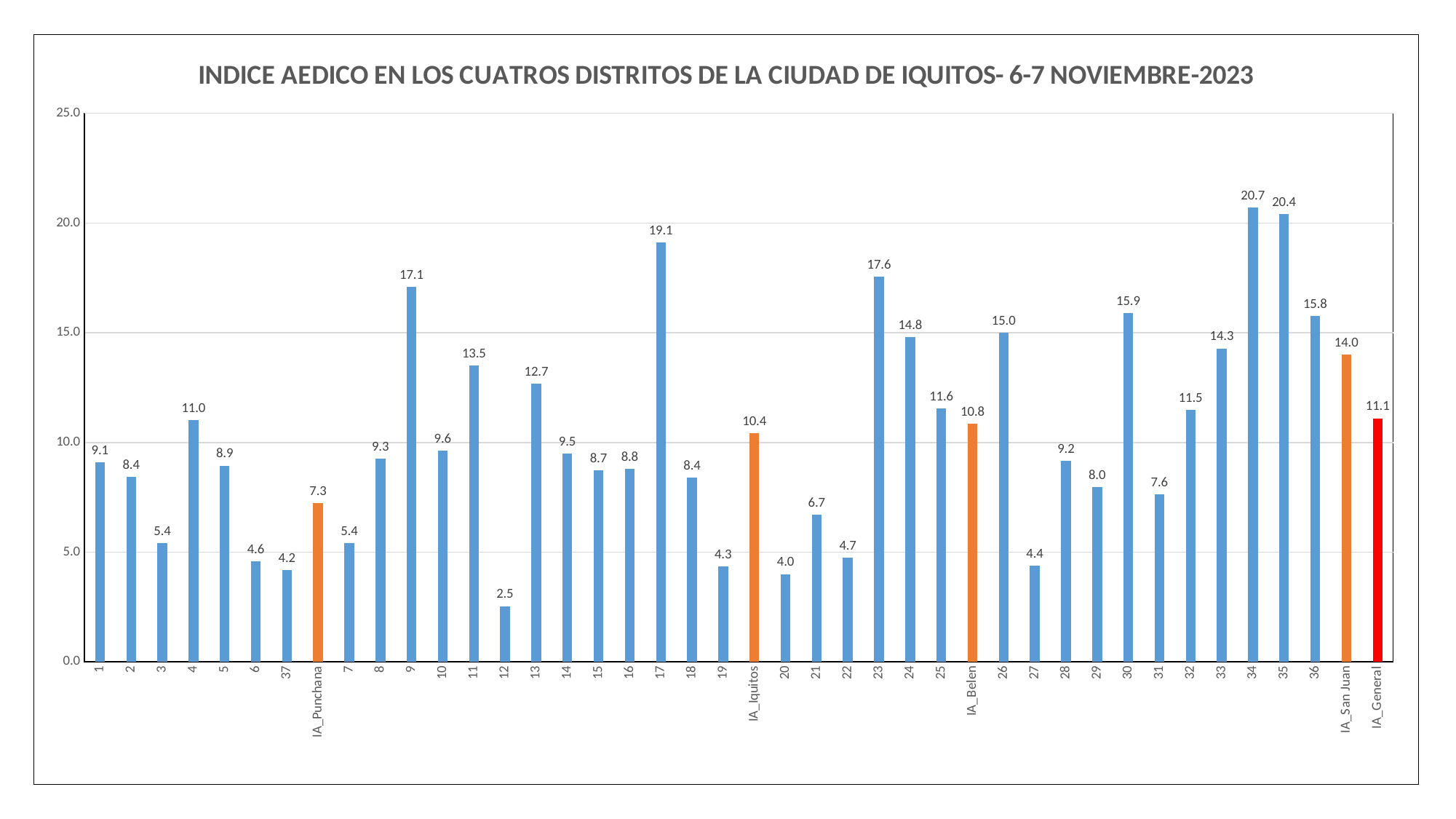
Which is larger, the value for IA_Belen or the value for IA_Iquitos? IA_Belen What is the value for IA_General? 11.1 What is the value for IA_Punchana? 7.3 How many bars are plotted in the chart? 42 What colour is the IA_General bar? red What is the value for category 17? 19.1 Which category has the lowest value? 12 What is the difference between the values for IA_San Juan and IA_Iquitos? 3.6 What is the difference between the values for category 34 and category 35? 0.3 What kind of chart is shown on the slide? bar chart Which category has the highest value? 34 Is the value for category 23 greater or less than 15.0? greater